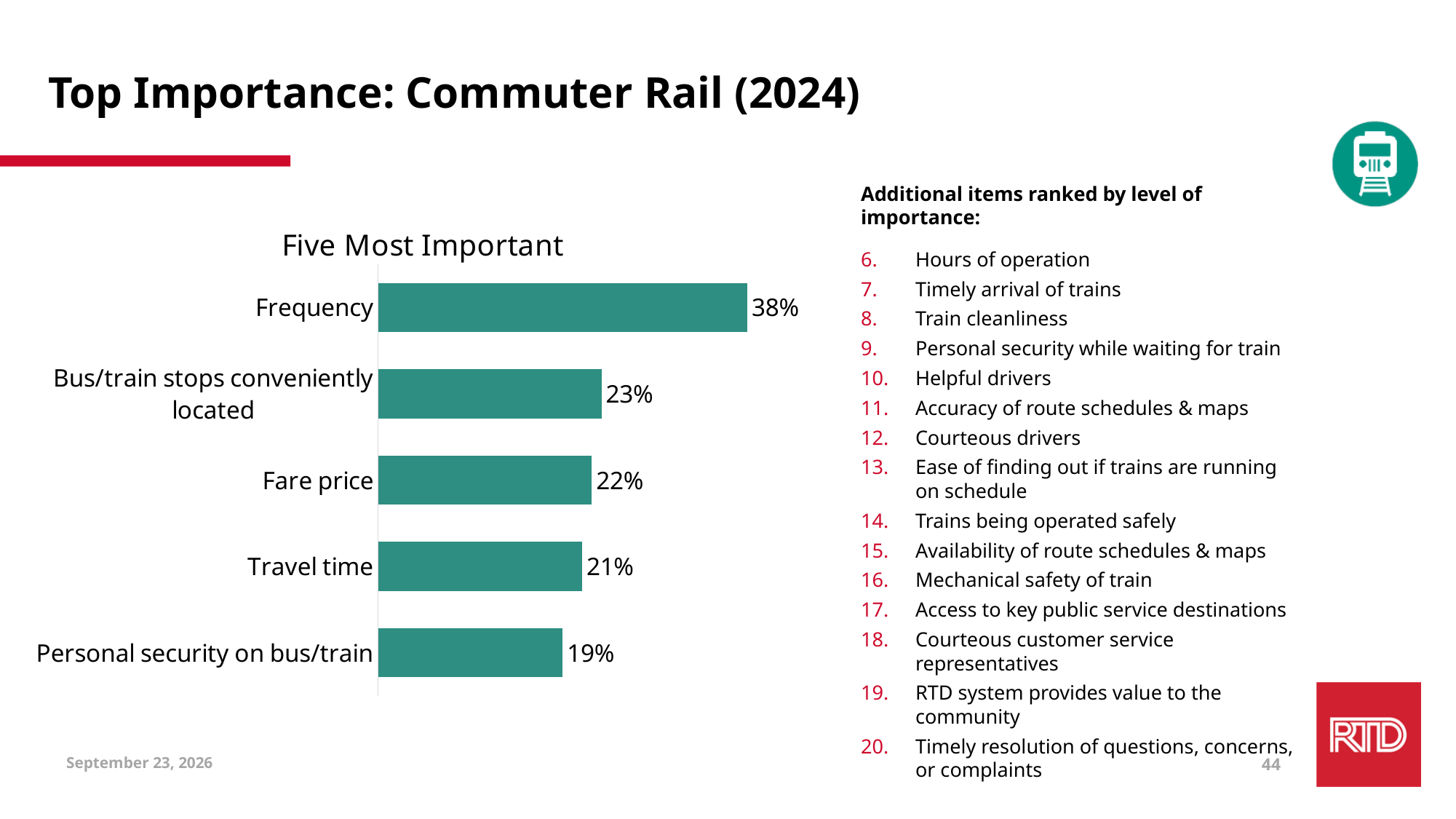
What is the difference between the values for Fare price and Personal security on bus/train? 3% Which category has the highest value? Frequency What is the title of the chart? Five Most Important What kind of chart is shown on the slide? Bar chart What is the value for Frequency? 38% What is the value for Travel time? 21% How many categories are shown in the chart? 5 Which category has the lowest value? Personal security on bus/train Which is larger, the value for Bus/train stops conveniently located or the value for Travel time? Bus/train stops conveniently located What is the difference between the values for Frequency and Bus/train stops conveniently located? 15% What is the value for Personal security on bus/train? 19% What is the value for Fare price? 22%